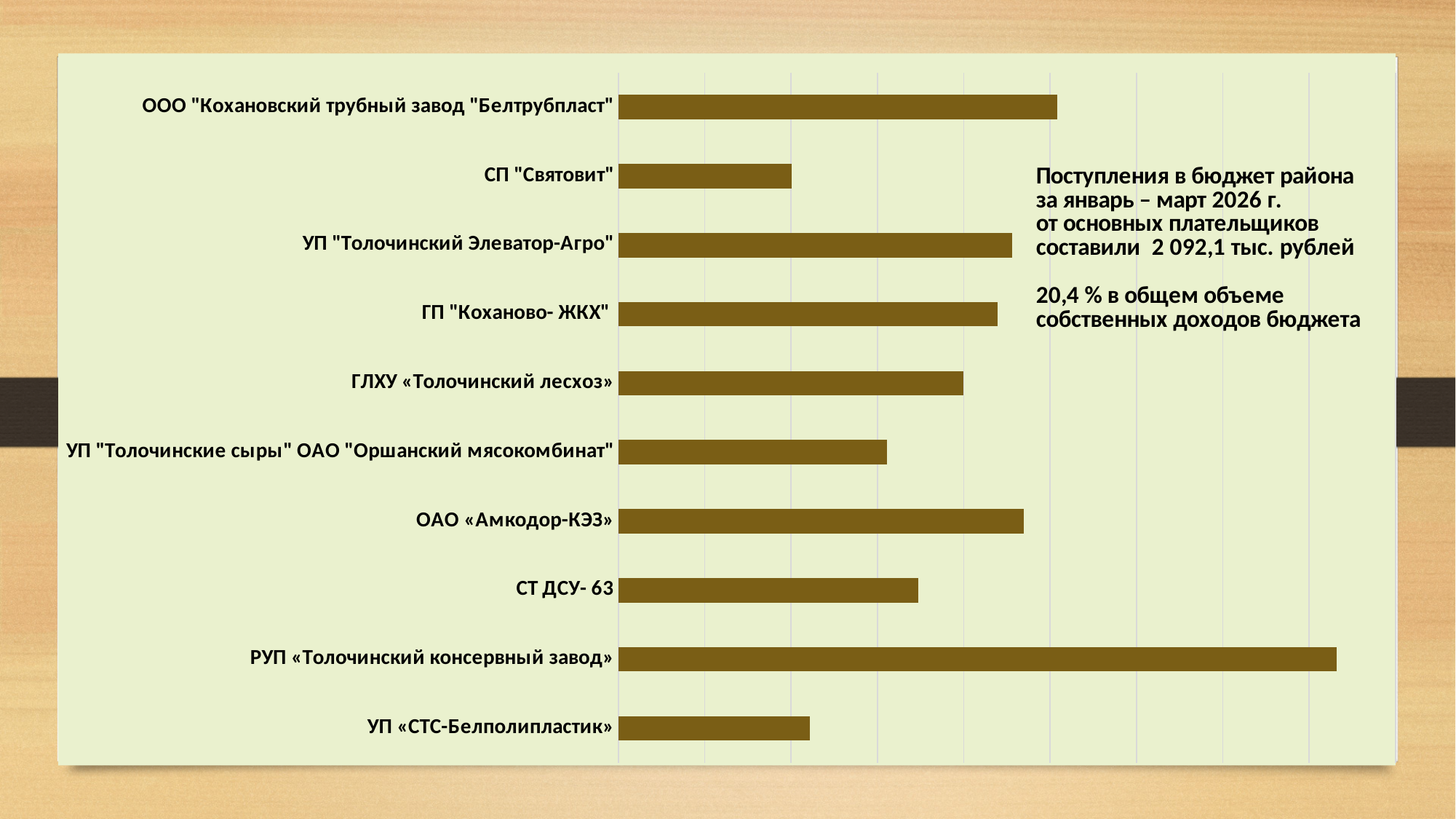
Which bar is longer: ООО "Кохановский трубный завод "Белтрубпласт" or ГЛХУ «Толочинский лесхоз»? ООО "Кохановский трубный завод "Белтрубпласт" Which organisation has the longest bar in the chart? РУП «Толочинский консервный завод» Which bar is longer: ОАО «Амкодор-КЭЗ» or УП "Толочинские сыры" ОАО "Оршанский мясокомбинат"? ОАО «Амкодор-КЭЗ» How many organisations (categories) are shown in the bar chart? 10 Which bar is longer: СП "Святовит" or ГП "Коханово- ЖКХ"? ГП "Коханово- ЖКХ" According to the text on the slide, what share of the budget's own revenues do these receipts represent? 20,4 % What kind of chart is shown on the slide? bar chart According to the text on the slide, what total amount did budget receipts from the main payers for January–March 2026 amount to? 2 092,1 тыс. рублей